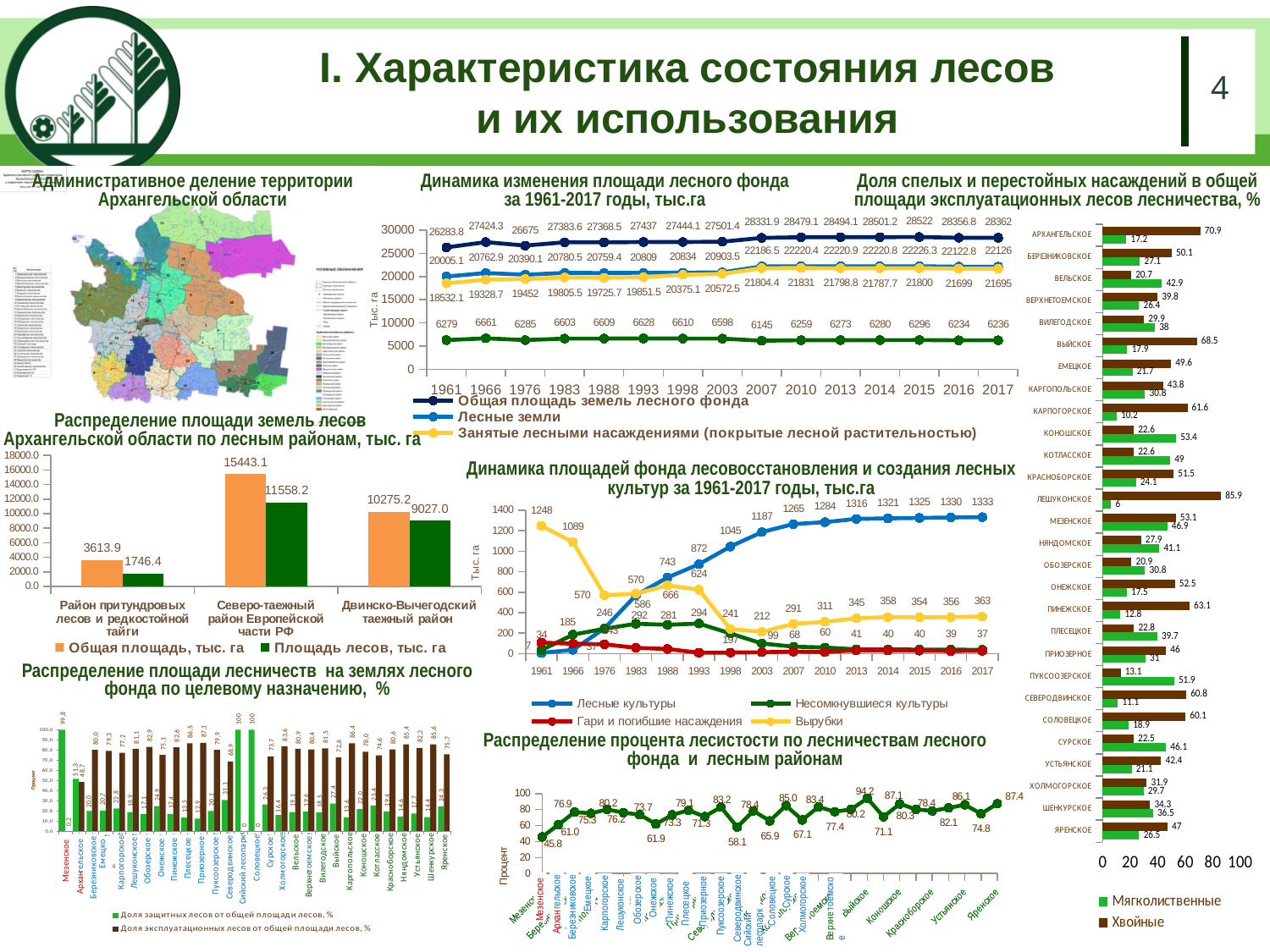
In the chart 'Динамика площадей фонда лесовосстановления и создания лесных культур за 1961-2017 годы, тыс.га', what is the value of 'Лесные культуры' in 2017? 1333 In the chart 'Динамика изменения площади лесного фонда за 1961-2017 годы, тыс.га', what is the value of 'Лесные земли' in 1961? 20005.1 In the chart 'Динамика изменения площади лесного фонда за 1961-2017 годы, тыс.га', what is the value of 'Общая площадь земель лесного фонда' in 2017? 28362 How many categories are shown in the chart 'Распределение площади земель лесов Архангельской области по лесным районам, тыс. га'? 3 In the chart 'Распределение площади земель лесов Архангельской области по лесным районам, тыс. га', what is the difference between 'Общая площадь' and 'Площадь лесов' for 'Северо-таежный район Европейской части РФ'? 3884.9 In the chart 'Доля спелых и перестойных насаждений в общей площади эксплуатационных лесов лесничества, %', which is larger for 'Архангельское': 'Мягколиственные' or 'Хвойные'? Хвойные In the chart 'Доля спелых и перестойных насаждений в общей площади эксплуатационных лесов лесничества, %', what is the value of 'Хвойные' for 'Архангельское'? 70.9 What kind of chart is 'Распределение площади земель лесов Архангельской области по лесным районам, тыс. га'? bar chart In the chart 'Распределение площади земель лесов Архангельской области по лесным районам, тыс. га', what is the value of 'Общая площадь, тыс. га' for 'Северо-таежный район Европейской части РФ'? 15443.1 In the chart 'Динамика площадей фонда лесовосстановления и создания лесных культур за 1961-2017 годы, тыс.га', does the 'Лесные культуры' series generally rise or fall from 1961 to 2017? rise How many series does the legend list in the chart 'Доля спелых и перестойных насаждений в общей площади эксплуатационных лесов лесничества, %'? 2 In the chart 'Доля спелых и перестойных насаждений в общей площади эксплуатационных лесов лесничества, %', which лесничество has the highest value for 'Хвойные'? Лешуконское